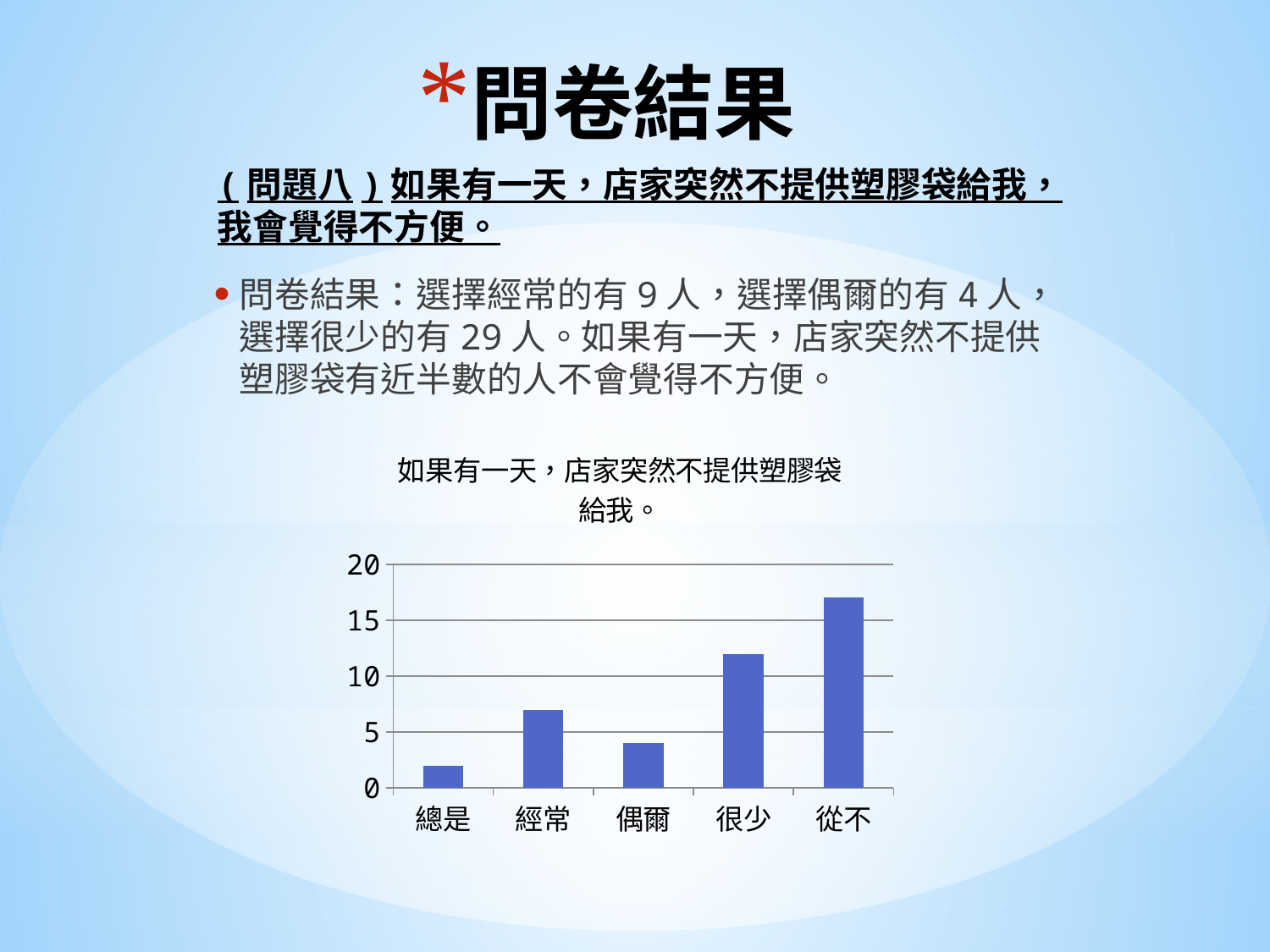
Which is larger, the value for 很少 or the value for 從不? 從不 Is the value for 很少 greater or less than 10? greater Is the value for 總是 greater or less than 5? less What is the highest value shown on the chart's vertical axis? 20 What is the title of the chart? 如果有一天，店家突然不提供塑膠袋給我。 How many categories are shown on the x axis of the chart? 5 What kind of chart is shown on the slide? bar chart Which category has the highest bar in the chart? 從不 Is the value for 經常 greater or less than 10? less Which category has the lowest bar in the chart? 總是 Which is larger, the value for 經常 or the value for 偶爾? 經常